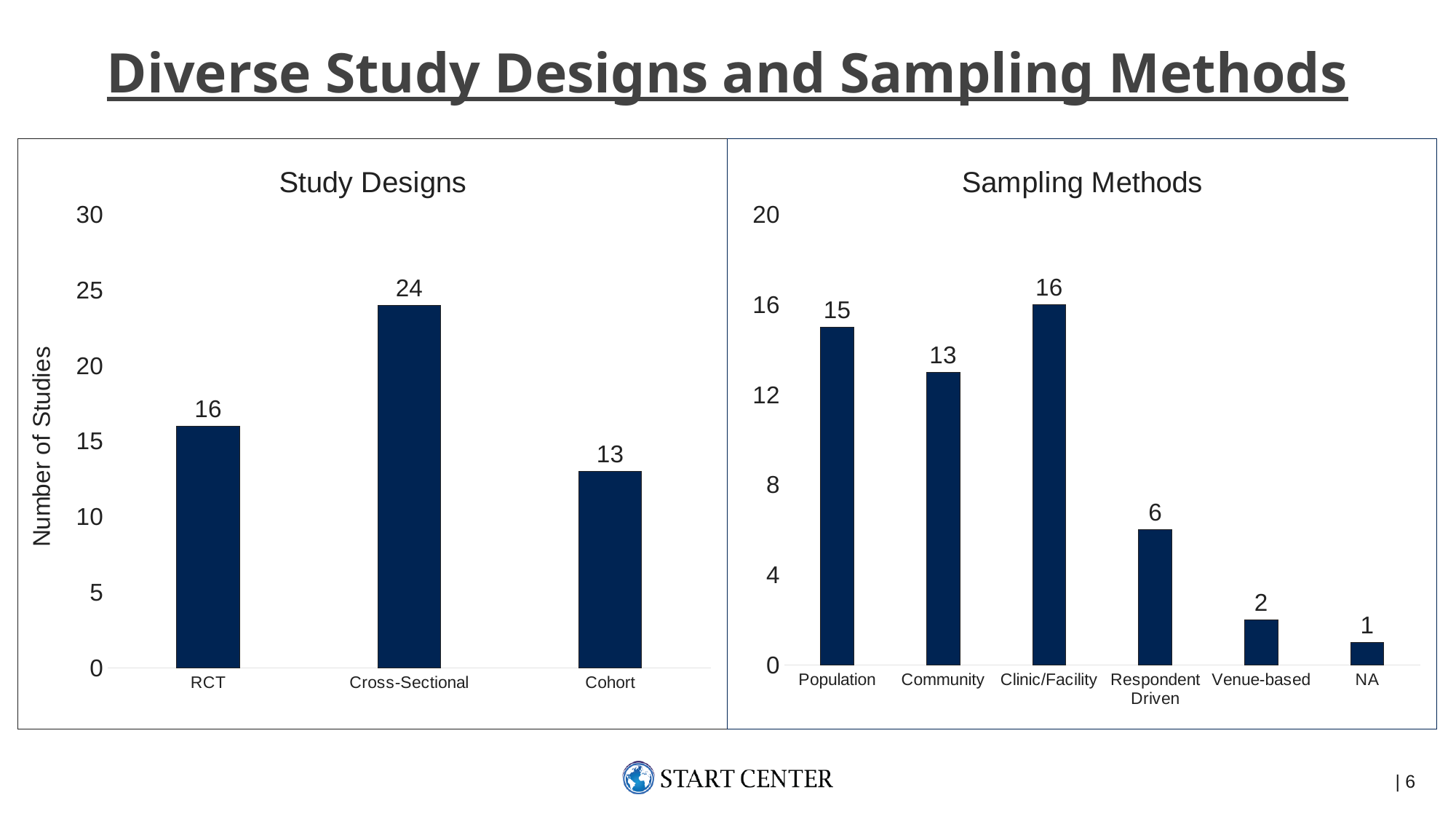
In the Sampling Methods chart, which sampling method has the highest value? Clinic/Facility In the Sampling Methods chart, what is the value for Respondent Driven? 6 In the Sampling Methods chart, which sampling method has the lowest value? NA In the Sampling Methods chart, which is larger, the value for Population or the value for Community? Population In the Study Designs chart, how many categories are shown? 3 In the Study Designs chart, what is the difference between the values for Cross-Sectional and RCT? 8 In the Study Designs chart, which study design has the lowest number of studies? Cohort What kind of chart is the Sampling Methods chart? Bar chart In the Sampling Methods chart, what is the difference between the values for Clinic/Facility and Venue-based? 14 In the Study Designs chart, what is the label of the vertical axis? Number of Studies In the Study Designs chart, what is the value for Cross-Sectional? 24 In the Sampling Methods chart, how many categories are shown? 6